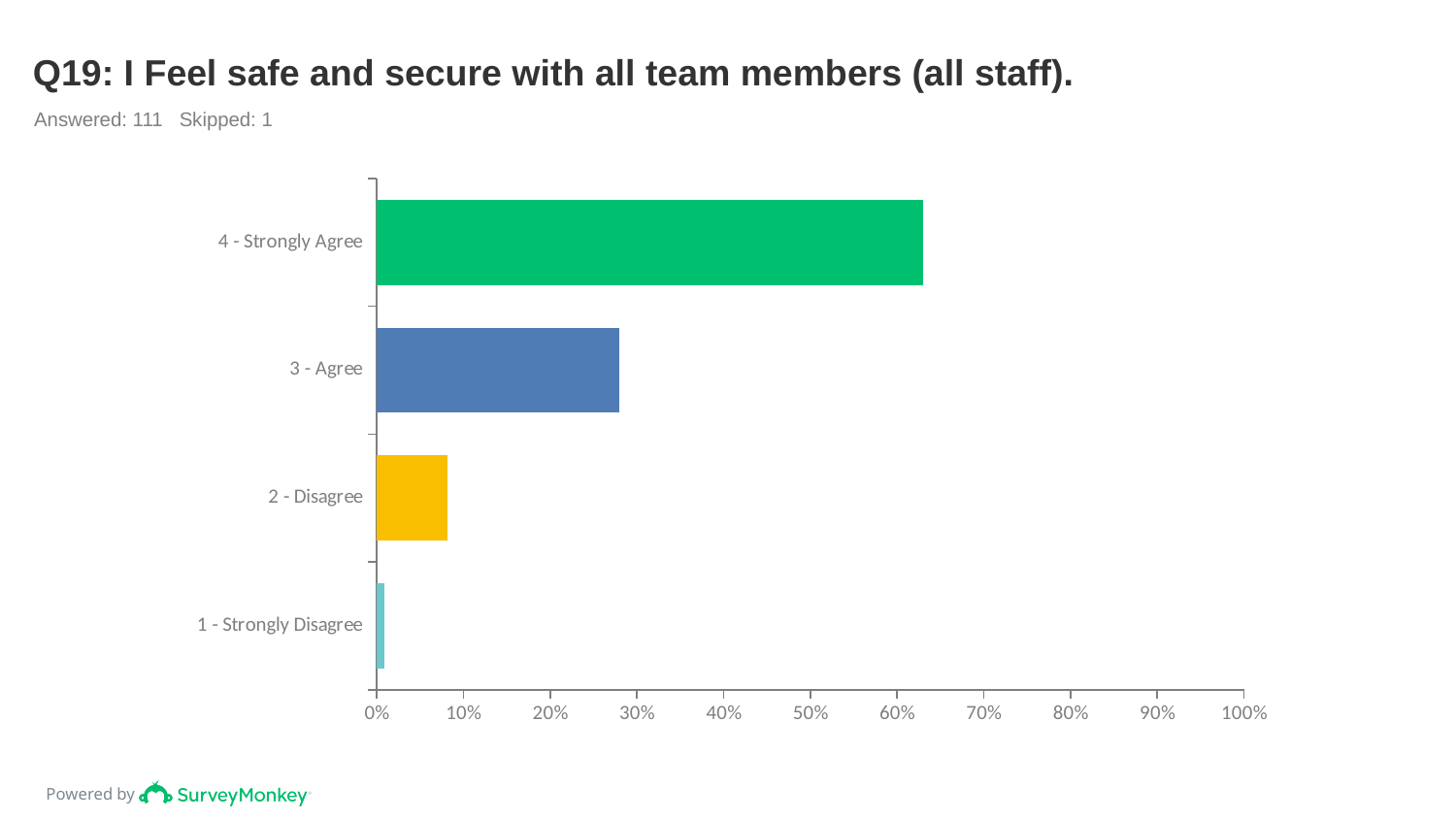
What kind of chart is shown on the slide? bar chart Which category has the lowest value? 1 - Strongly Disagree Is the value for 4 - Strongly Agree greater or less than 60%? greater What is the title of the chart? Q19: I Feel safe and secure with all team members (all staff). Which category has the highest value? 4 - Strongly Agree Is the value for 4 - Strongly Agree greater or less than 70%? less Is the value for 2 - Disagree greater or less than 10%? less How many respondents answered the question according to the slide? 111 Which is larger, the value for 3 - Agree or the value for 2 - Disagree? 3 - Agree How many categories are plotted in the chart? 4